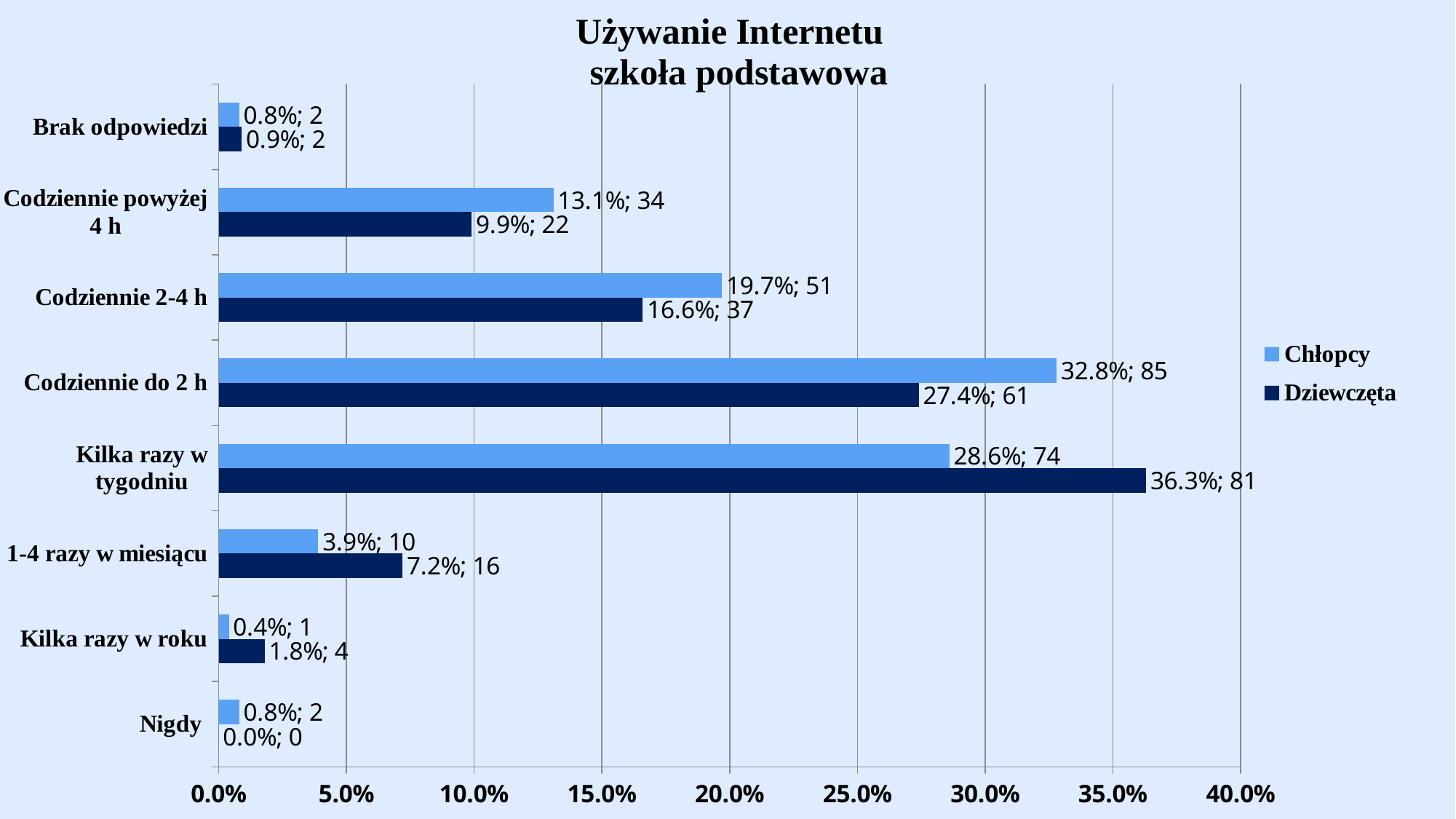
Is the value for Dziewczęta in "Kilka razy w tygodniu" greater or less than 35.0%? greater What is the difference in percentage points between Chłopcy and Dziewczęta in the category "Codziennie do 2 h"? 5.4 Which category has the lowest percentage for Dziewczęta? Nigdy What is the title of the chart? Używanie Internetu szkoła podstawowa What kind of chart is shown on the slide? bar chart In the category "1-4 razy w miesiącu", which series has the larger percentage, Chłopcy or Dziewczęta? Dziewczęta How many categories are shown on the vertical axis? 8 What is the percentage for Chłopcy in the category "Codziennie do 2 h"? 32.8% What is the percentage for Dziewczęta in the category "Kilka razy w tygodniu"? 36.3% Which category has the highest percentage for Chłopcy? Codziennie do 2 h How many Dziewczęta respondents are in the category "Codziennie 2-4 h"? 37 How many series does the legend list? 2